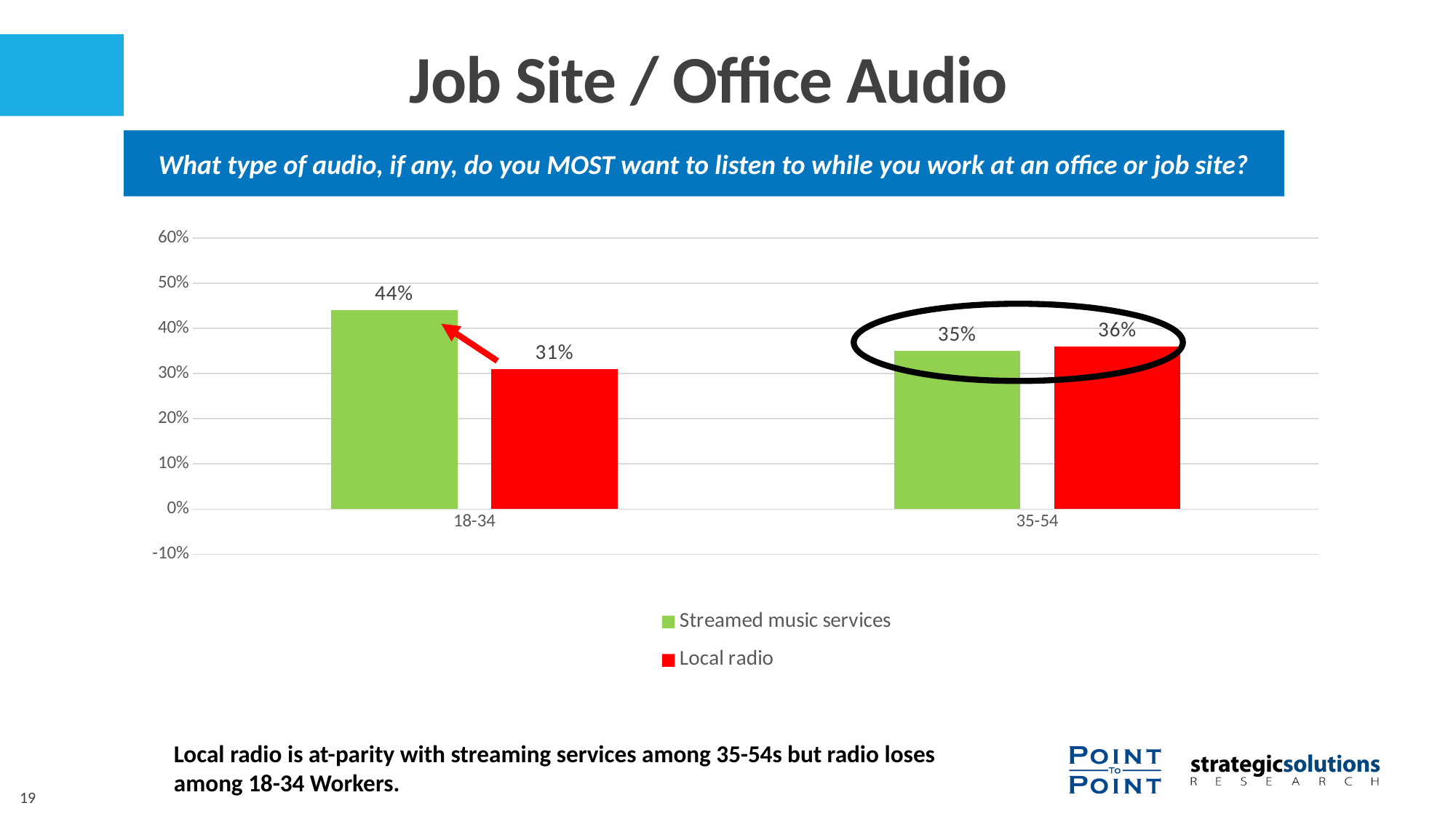
What percentage of 35-54 workers most want to listen to local radio? 36% What is the difference between streamed music services and local radio among 18-34 workers? 13 percentage points Among 18-34 workers, which is larger: streamed music services or local radio? Streamed music services What percentage of 35-54 workers most want to listen to streamed music services? 35% What percentage of 18-34 workers most want to listen to local radio? 31% Which age group has the lowest value for local radio? 18-34 What kind of chart is shown on the slide? Bar chart How many series does the legend list? 2 What percentage of 18-34 workers most want to listen to streamed music services? 44% What colour represents local radio in the chart? Red How many age groups are shown on the x axis? 2 Which age group has the highest value for streamed music services? 18-34